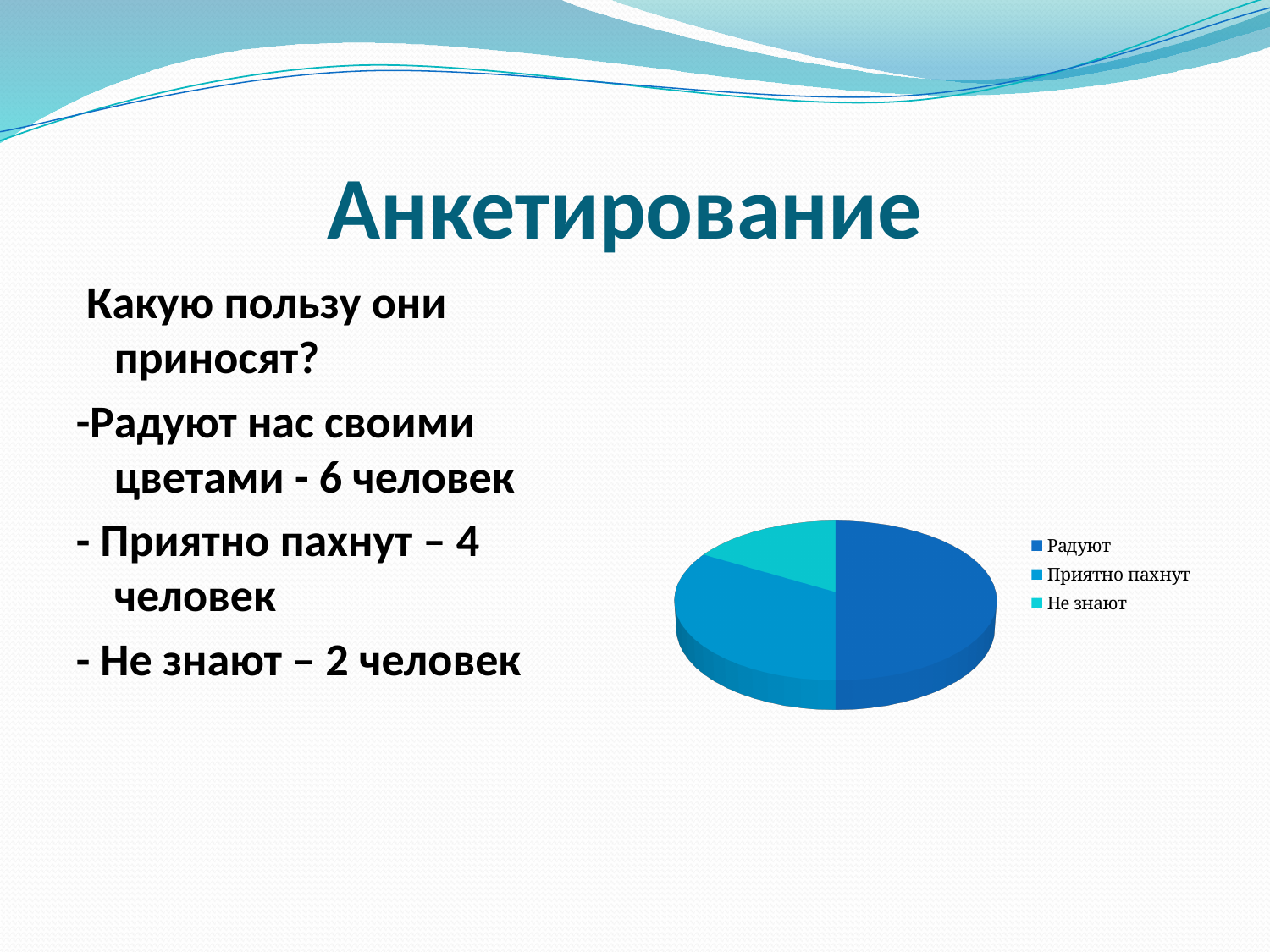
How many slices does the pie chart have? 3 What share of the pie does the Радуют slice represent? 50% Which slice is larger in the pie chart, Приятно пахнут or Не знают? Приятно пахнут According to the slide, how many people answered Радуют? 6 человек What kind of chart is shown on the slide? pie chart Which slice is larger in the pie chart, Радуют or Приятно пахнут? Радуют According to the slide, how many people answered Приятно пахнут? 4 человек What is the title of the slide containing the pie chart? Анкетирование According to the slide, how many people answered Не знают? 2 человек How many entries does the legend of the pie chart list? 3 Which category has the smallest slice in the pie chart? Не знают Which category has the largest slice in the pie chart? Радуют